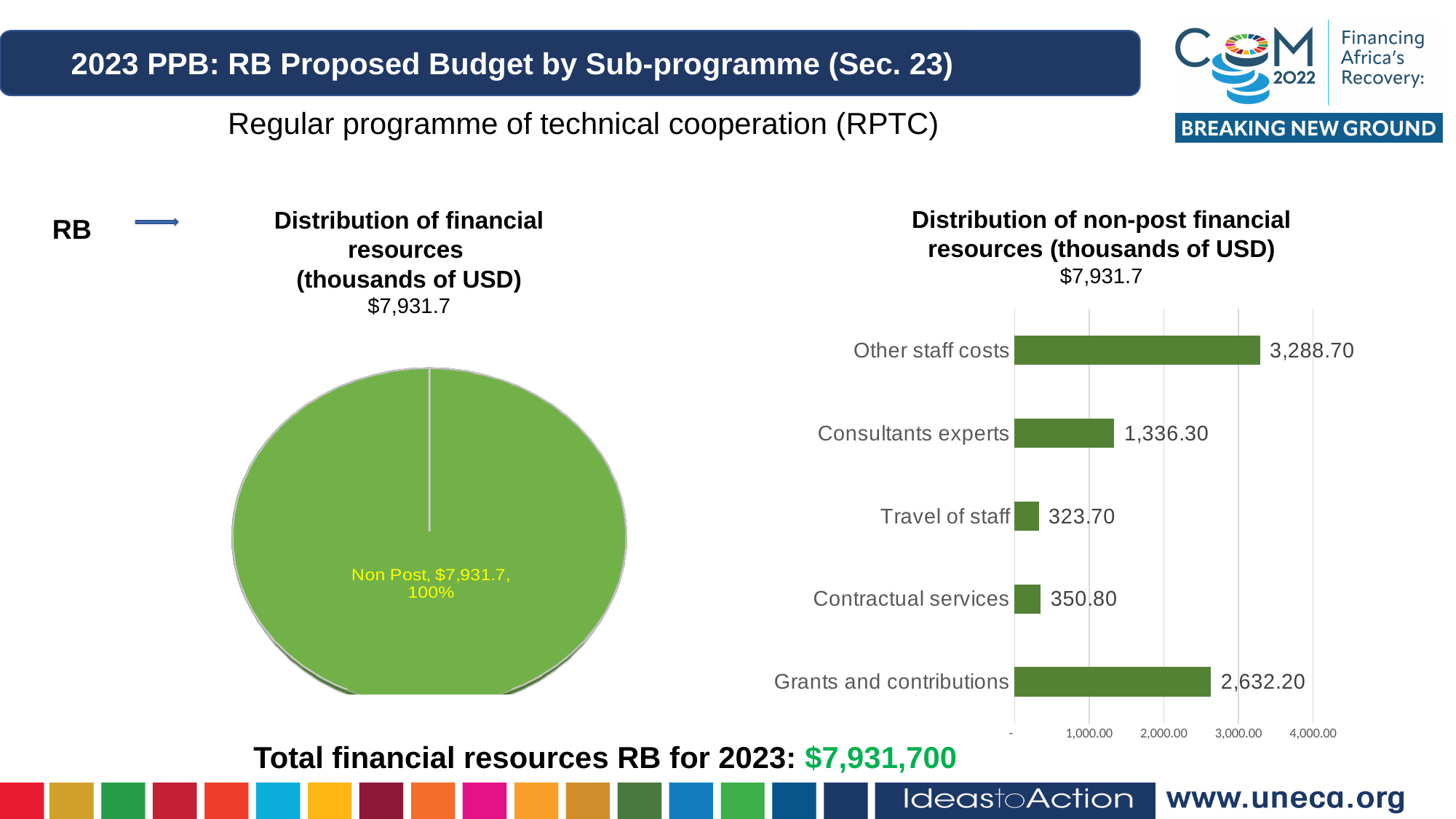
In the 'Distribution of non-post financial resources' bar chart, is the value for Consultants experts greater or less than 1,000.00? greater In the 'Distribution of non-post financial resources' bar chart, which is larger: Consultants experts or Contractual services? Consultants experts What kind of chart is the 'Distribution of financial resources' chart on the left? Pie chart In the 'Distribution of non-post financial resources' bar chart, which category has the highest value? Other staff costs How many categories are shown in the 'Distribution of non-post financial resources' bar chart? 5 In the 'Distribution of non-post financial resources' bar chart, what is the value for Grants and contributions? 2,632.20 In the 'Distribution of non-post financial resources' bar chart, what is the difference between Other staff costs and Grants and contributions? 656.50 In the 'Distribution of financial resources' pie chart, what share does the Non Post slice represent? 100% What kind of chart is the 'Distribution of non-post financial resources' chart? Bar chart In the 'Distribution of non-post financial resources' bar chart, what is the value for Other staff costs? 3,288.70 In the 'Distribution of non-post financial resources' bar chart, which category has the lowest value? Travel of staff In the 'Distribution of non-post financial resources' bar chart, what is the value for Travel of staff? 323.70